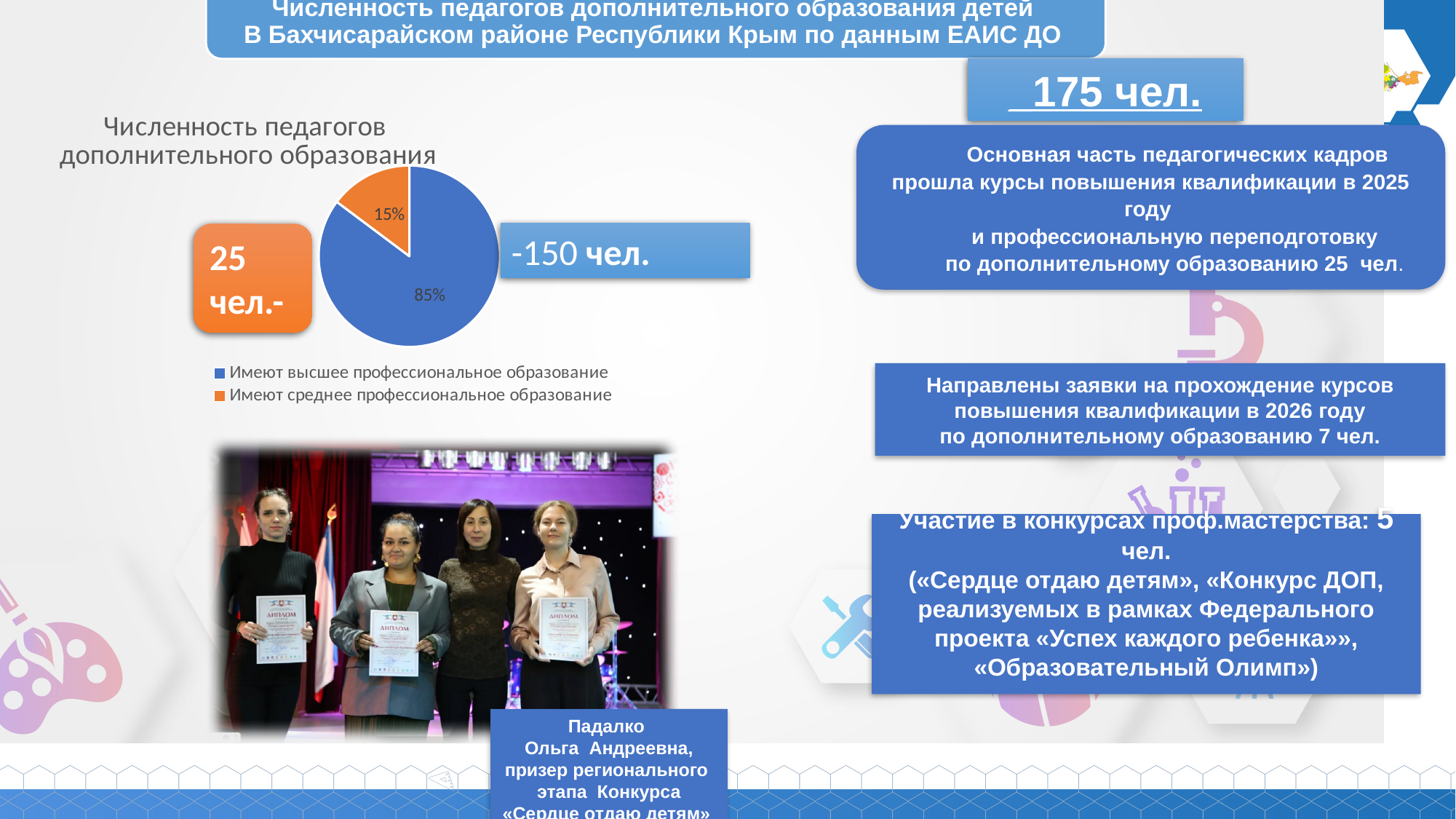
Which is larger: the share with higher professional education or the share with secondary professional education? Имеют высшее профессиональное образование What is the title of the pie chart? Численность педагогов дополнительного образования Which category has the smallest slice in the pie chart? Имеют среднее профессиональное образование What is the value printed on the blue slice of the pie chart? 85% What is the difference in percentage points between the "Имеют высшее профессиональное образование" slice and the "Имеют среднее профессиональное образование" slice? 70 percentage points How many slices does the pie chart have? 2 What kind of chart is shown on the slide? pie chart What colour is the slice for "Имеют среднее профессиональное образование"? orange What share of the pie is labelled "Имеют среднее профессиональное образование"? 15% What share of the pie is labelled "Имеют высшее профессиональное образование"? 85% Which category has the largest slice in the pie chart? Имеют высшее профессиональное образование How many entries does the pie chart's legend list? 2